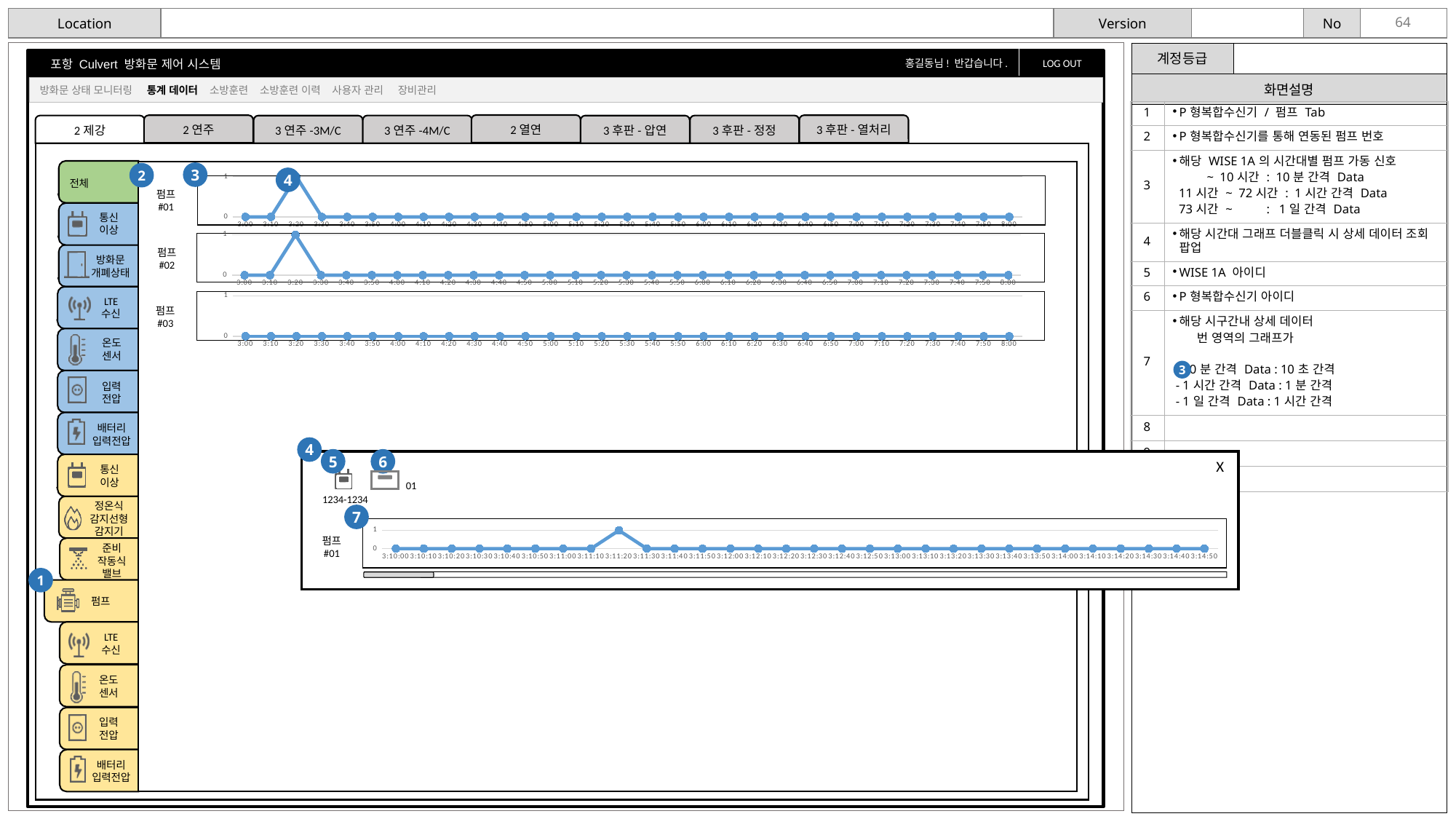
What kind of chart is the 펌프 #01 chart in the upper panel? line chart In the upper 펌프 #01 chart, what is the value at 3:00? 0 In the popup 펌프 #01 chart at the bottom, at which time is the value highest? 3:11:20 In the upper 펌프 #01 chart, what is the value at 3:20? 1 In the popup 펌프 #01 chart at the bottom, what is the value at 3:11:20? 1 In the upper 펌프 #01 chart, at which time is the value highest? 3:20 In the upper 펌프 #01 chart, which is larger, the value at 3:20 or the value at 3:30? 3:20 In the upper 펌프 #01 chart, what is the difference between the value at 3:20 and the value at 3:10? 1 In the 펌프 #02 chart, what is the value at 3:10? 0 In the 펌프 #03 chart, what is the value at 3:20? 0 What is the first time label on the x axis of the popup 펌프 #01 chart at the bottom? 3:10:00 In the 펌프 #02 chart, at which time is the value highest? 3:20